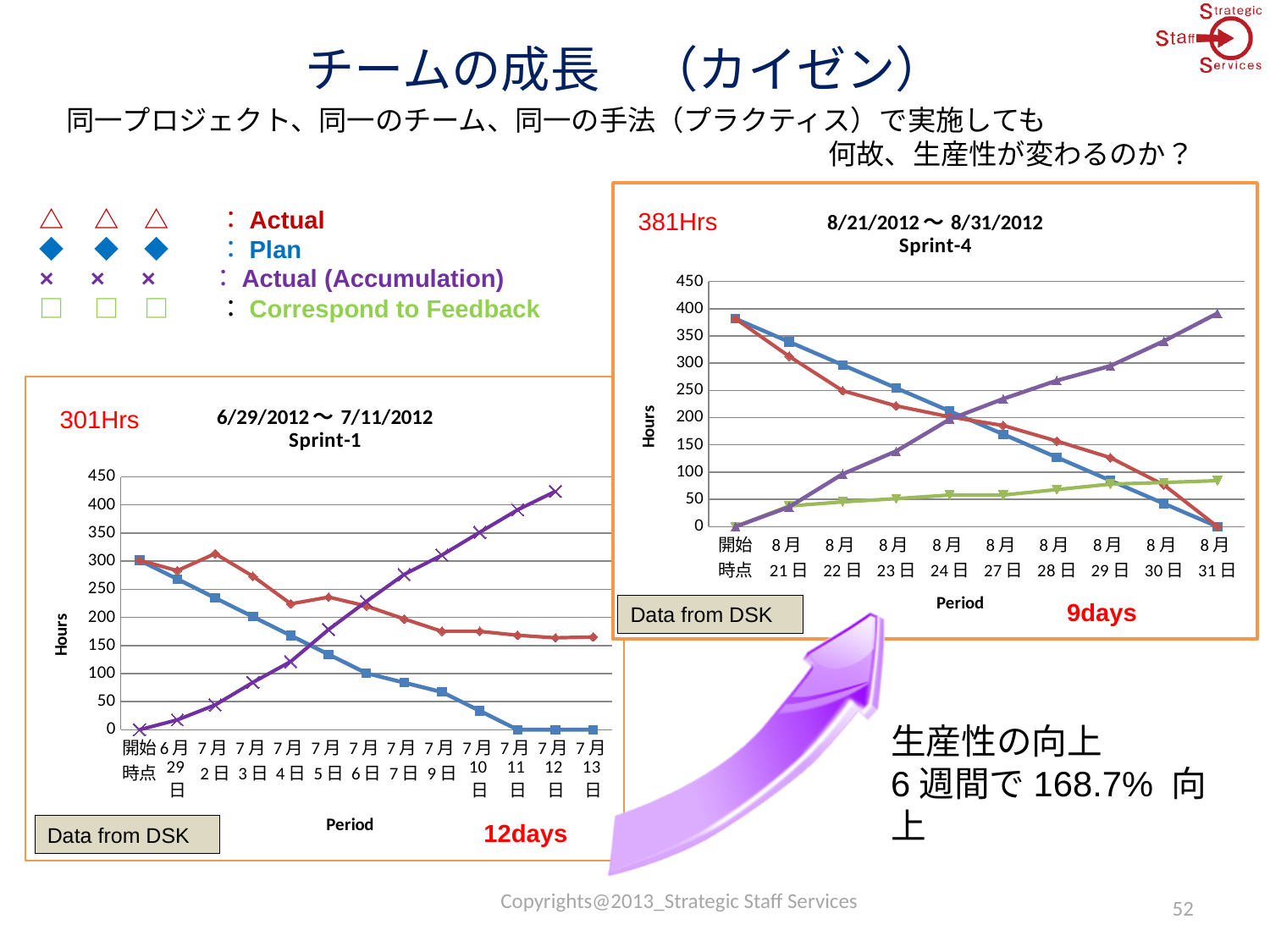
In the Sprint-4 chart, what is the Plan value on 8月31日? 0 What is the label of the y axis on the Sprint-1 chart? Hours In the Sprint-4 chart, is the Correspond to Feedback value on 8月31日 greater or less than 100? less In the Sprint-1 chart, does the Plan line rise or fall along the x axis? Falls In the Sprint-4 chart, what is the Actual (Accumulation) value at 開始時点? 0 What kind of chart is the Sprint-1 chart? Line chart How many points are plotted along the x axis of the Sprint-4 chart? 10 How many points are plotted along the x axis of the Sprint-1 chart? 13 In the Sprint-1 chart, what is the Plan value on 7月11日? 0 In the Sprint-4 chart, does the Actual (Accumulation) line rise or fall along the x axis? Rises What date range is shown in the title of the Sprint-4 chart? 8/21/2012 ～ 8/31/2012